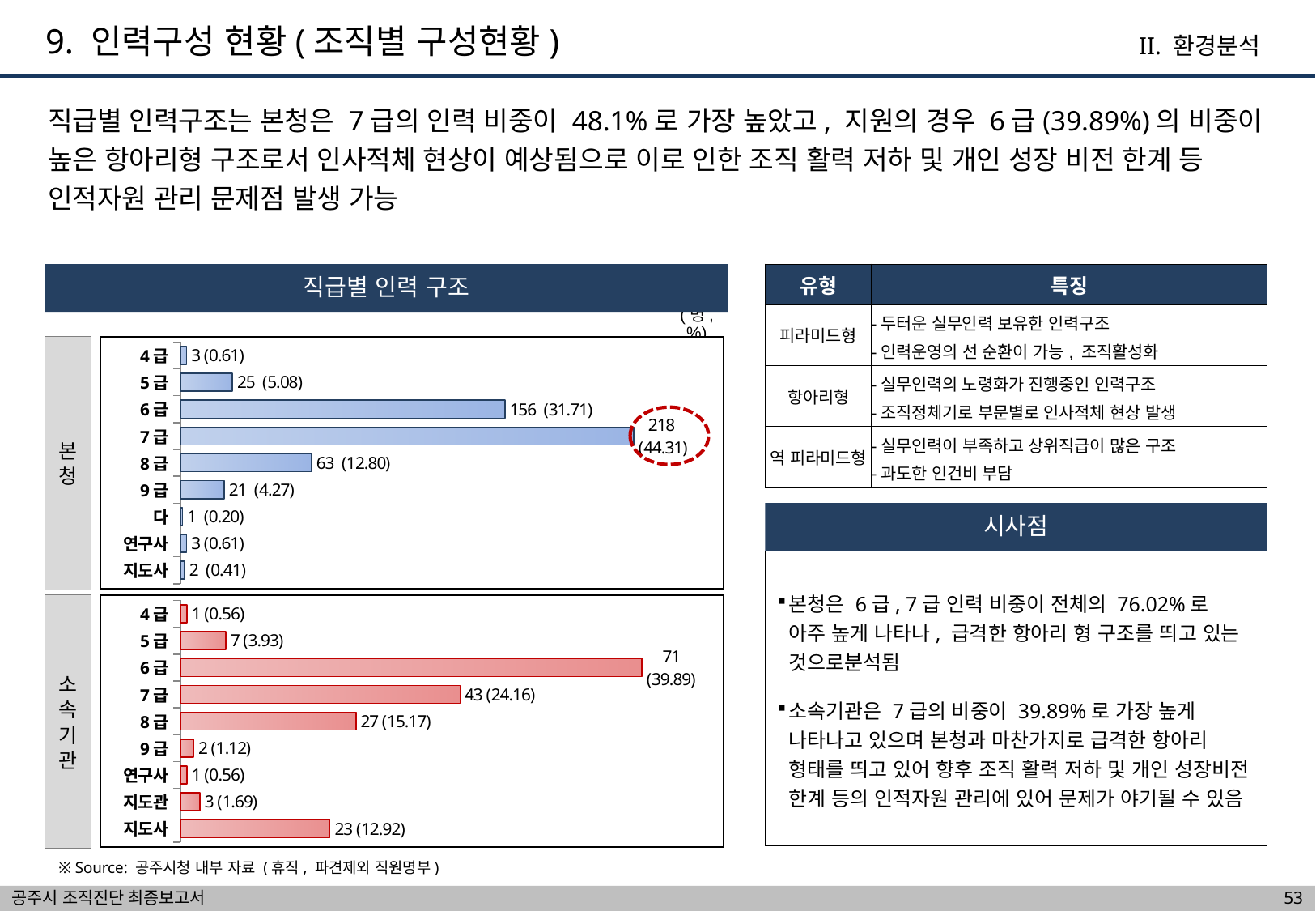
How many categories are shown in the 본청 chart? 9 In the 소속기관 chart, what is the difference in headcount between 6급 and 7급? 28 In the 본청 chart, what is the value shown for 6급? 156 (31.71) In the 본청 chart, which category has the lowest value? 다 In the 소속기관 chart, what is the value shown for 6급? 71 (39.89) What type of chart is used for 직급별 인력 구조? Bar chart In the 본청 chart, what is the difference in headcount between 7급 and 6급? 62 In the 소속기관 chart, what is the value shown for 지도사? 23 (12.92) In the 본청 chart, which category has the highest value? 7급 In the 본청 chart, what is the value shown for 7급? 218 (44.31) In the 소속기관 chart, which category has the highest value? 6급 In the 소속기관 chart, which is larger, 8급 or 지도사? 8급